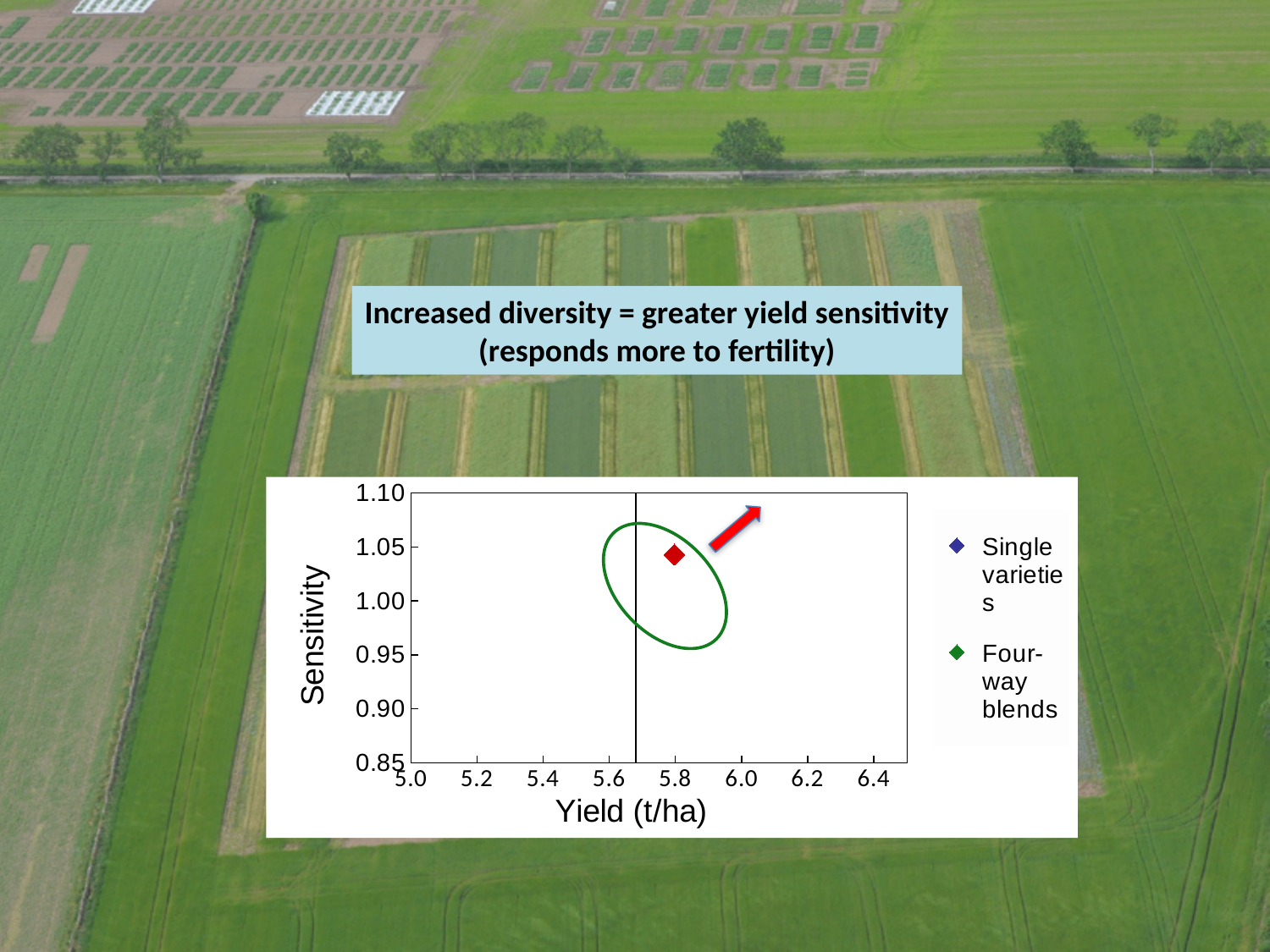
What kind of chart is shown on the slide? scatter chart What is the title of the chart's x axis? Yield (t/ha) What is the highest value shown on the chart's Sensitivity axis? 1.10 What are the two series named in the chart's legend? Single varieties and Four-way blends How many series does the chart's legend list? 2 Is the sensitivity value of the plotted red diamond point greater or less than 1.00? greater How many data points are visibly plotted on the chart? 1 Is the yield value of the plotted red diamond point greater or less than 6.0? less Is the yield value of the plotted red diamond point greater or less than 5.6? greater